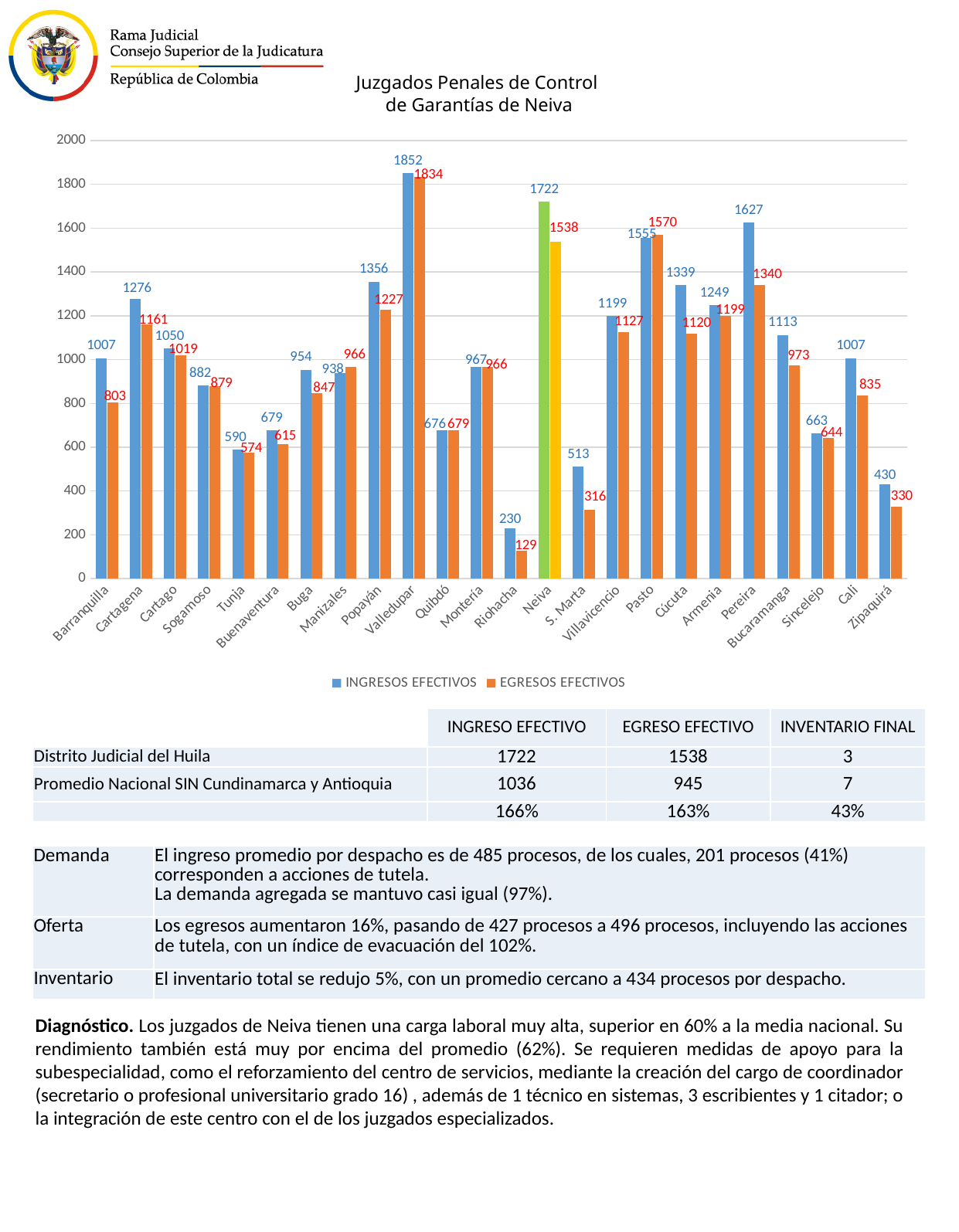
Which city has the lowest EGRESOS EFECTIVOS value? Riohacha Which city has the highest INGRESOS EFECTIVOS value? Valledupar What is the value of INGRESOS EFECTIVOS for Neiva? 1722 What is the difference between INGRESOS EFECTIVOS and EGRESOS EFECTIVOS for Pereira? 287 What is the value of EGRESOS EFECTIVOS for Pereira? 1340 What kind of chart is shown on the slide? bar chart Is the value of INGRESOS EFECTIVOS for S. Marta greater or less than 600? less What is the difference between INGRESOS EFECTIVOS and EGRESOS EFECTIVOS for Neiva? 184 How many cities are shown on the x axis of the chart? 24 What is the value of EGRESOS EFECTIVOS for Riohacha? 129 Which is larger: INGRESOS EFECTIVOS for Pereira or INGRESOS EFECTIVOS for Cúcuta? Pereira How many series does the legend list? 2